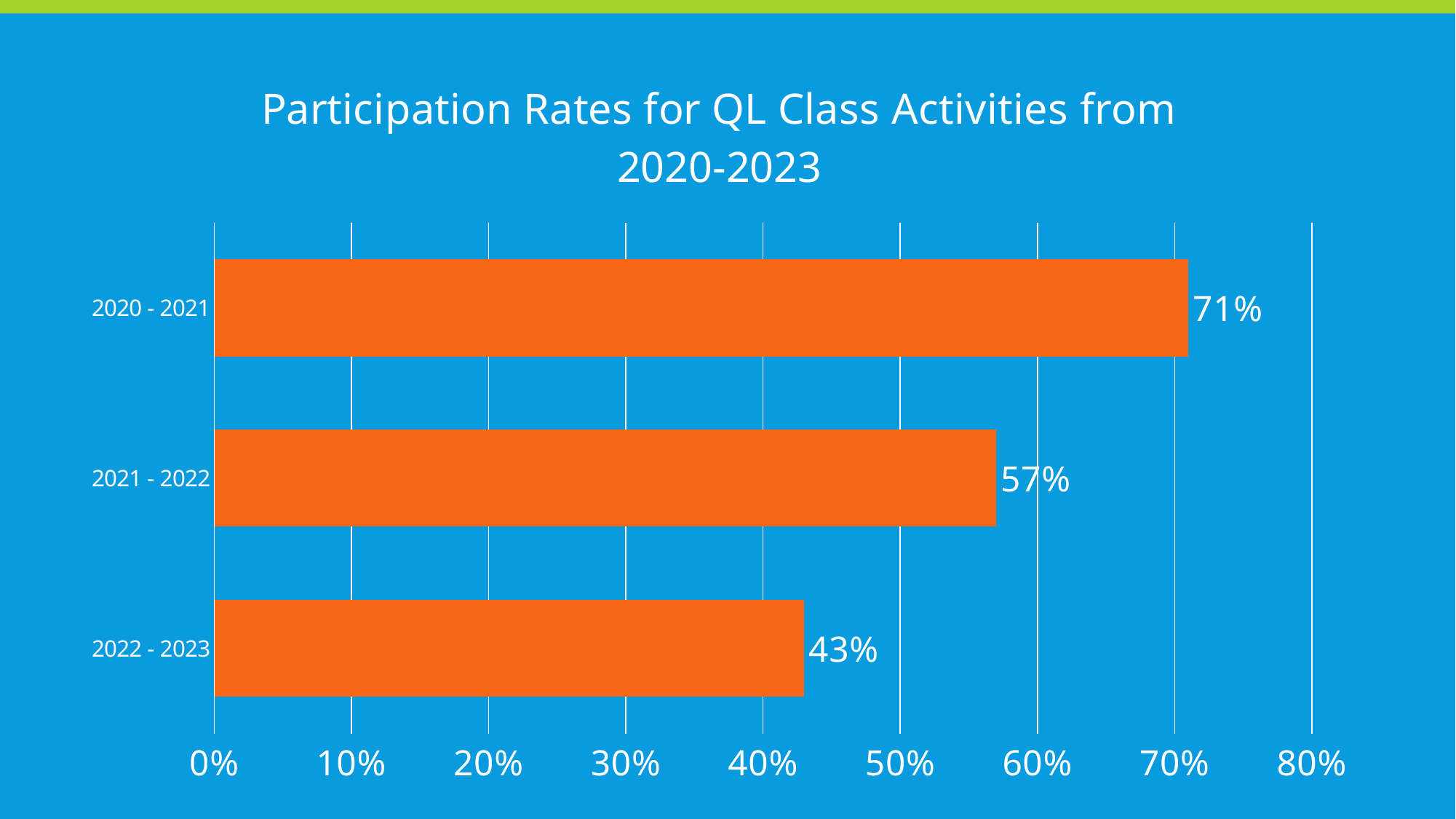
How many year ranges are shown in the chart? 3 Is the participation rate for 2021 - 2022 greater or less than 50%? greater What is the participation rate for 2022 - 2023? 43% Which year range has the lowest participation rate? 2022 - 2023 Which year range has the highest participation rate? 2020 - 2021 What is the participation rate for 2020 - 2021? 71% What kind of chart is shown on the slide? Bar chart What is the title of the chart? Participation Rates for QL Class Activities from 2020-2023 What is the difference between the participation rates for 2020 - 2021 and 2022 - 2023? 28% Which has a higher participation rate, 2021 - 2022 or 2022 - 2023? 2021 - 2022 What is the difference between the participation rates for 2021 - 2022 and 2022 - 2023? 14% What is the participation rate for 2021 - 2022? 57%